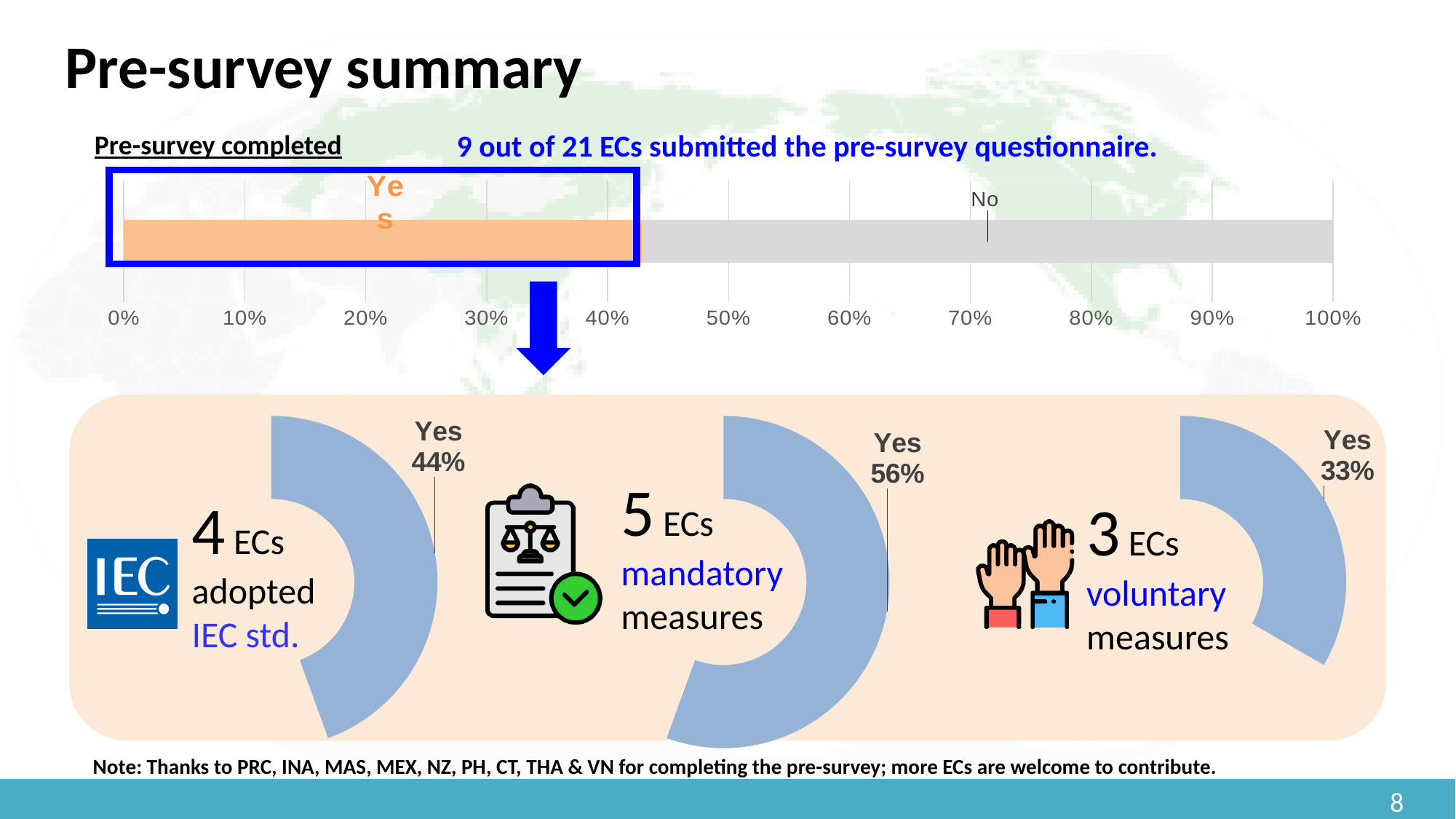
What is the difference between the 'Yes' percentage in the 'mandatory measures' chart and the 'Yes' percentage in the 'voluntary measures' chart? 23% In the 'mandatory measures' chart at the bottom centre, what percentage is labelled 'Yes'? 56% In the 'Pre-survey completed' bar chart, how many segments (categories) make up the bar? 2 In the 'adopted IEC std.' chart at the bottom left, what percentage is labelled 'Yes'? 44% Among the three bottom charts (adopted IEC std., mandatory measures, voluntary measures), which has the highest 'Yes' percentage? mandatory measures In the 'Pre-survey completed' bar chart, which segment is larger, 'Yes' or 'No'? No In the 'Pre-survey completed' bar chart, what is the highest value shown on the percentage axis? 100% In the 'Pre-survey completed' bar chart, is the 'Yes' segment greater or less than 50%? less In the 'voluntary measures' chart at the bottom right, what percentage is labelled 'Yes'? 33% In the 'Pre-survey completed' bar chart, what colour is the 'Yes' segment? orange In the 'Pre-survey completed' bar chart, is the 'No' segment greater or less than 50%? greater What kind of chart is the 'Pre-survey completed' chart at the top of the slide? bar chart